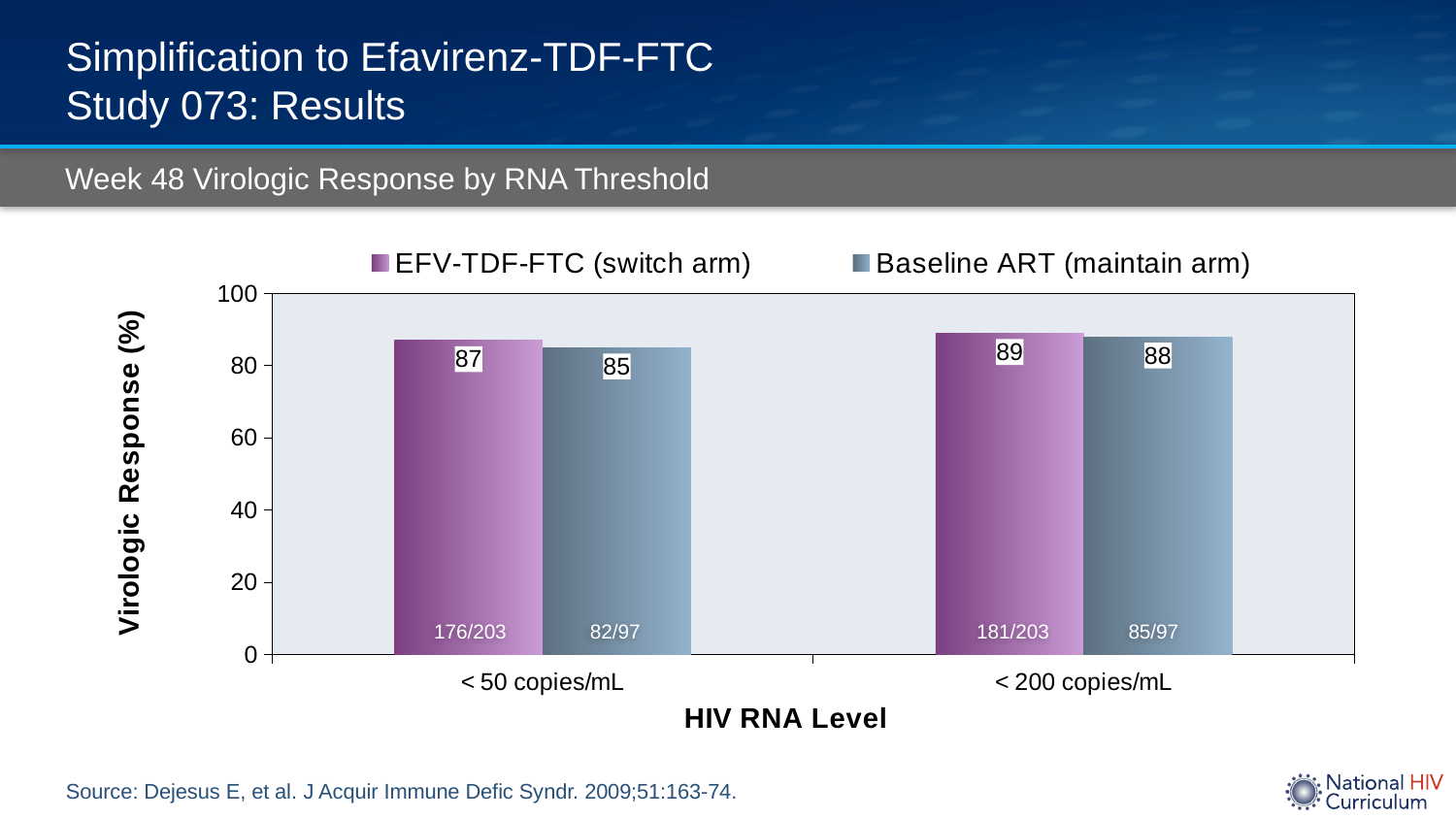
What is the label of the y axis? Virologic Response (%) What fraction of patients is shown for EFV-TDF-FTC (switch arm) at < 200 copies/mL? 181/203 Which bar has the highest virologic response on the chart? EFV-TDF-FTC (switch arm) at < 200 copies/mL Which bar has the lowest virologic response on the chart? Baseline ART (maintain arm) at < 50 copies/mL How many HIV RNA level categories are shown on the x axis? 2 What kind of chart is shown on the slide? Bar chart What is the virologic response (%) for EFV-TDF-FTC (switch arm) at < 50 copies/mL? 87 How many series does the legend list? 2 What is the virologic response (%) for Baseline ART (maintain arm) at < 200 copies/mL? 88 What is the difference in virologic response between EFV-TDF-FTC (switch arm) and Baseline ART (maintain arm) at < 50 copies/mL? 2 What is the virologic response (%) for Baseline ART (maintain arm) at < 50 copies/mL? 85 Which series has the larger virologic response at < 200 copies/mL, EFV-TDF-FTC (switch arm) or Baseline ART (maintain arm)? EFV-TDF-FTC (switch arm)